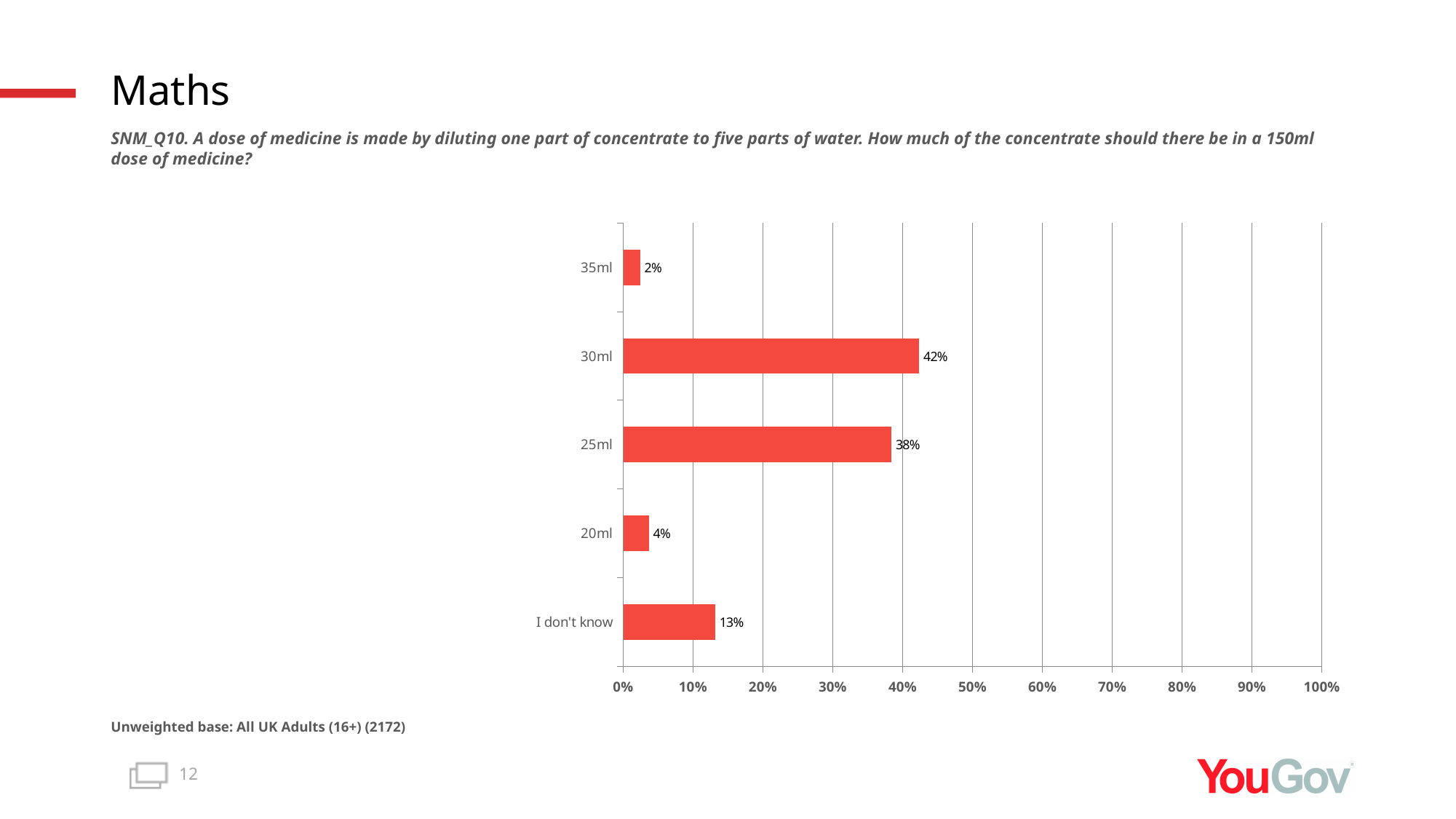
Is the value for 25ml greater or less than 30%? greater Which answer option has the highest percentage? 30ml What percentage of respondents said 'I don't know'? 13% What percentage of respondents answered 30ml? 42% How many answer options are shown in the chart? 5 What percentage of respondents answered 20ml? 4% What type of chart is shown on the slide? Bar chart Which has a larger percentage, 20ml or 'I don't know'? I don't know What is the difference in percentage points between the 30ml and 25ml responses? 4 What percentage of respondents answered 25ml? 38% Which answer option has the lowest percentage? 35ml What is the unweighted base stated below the chart? All UK Adults (16+) (2172)